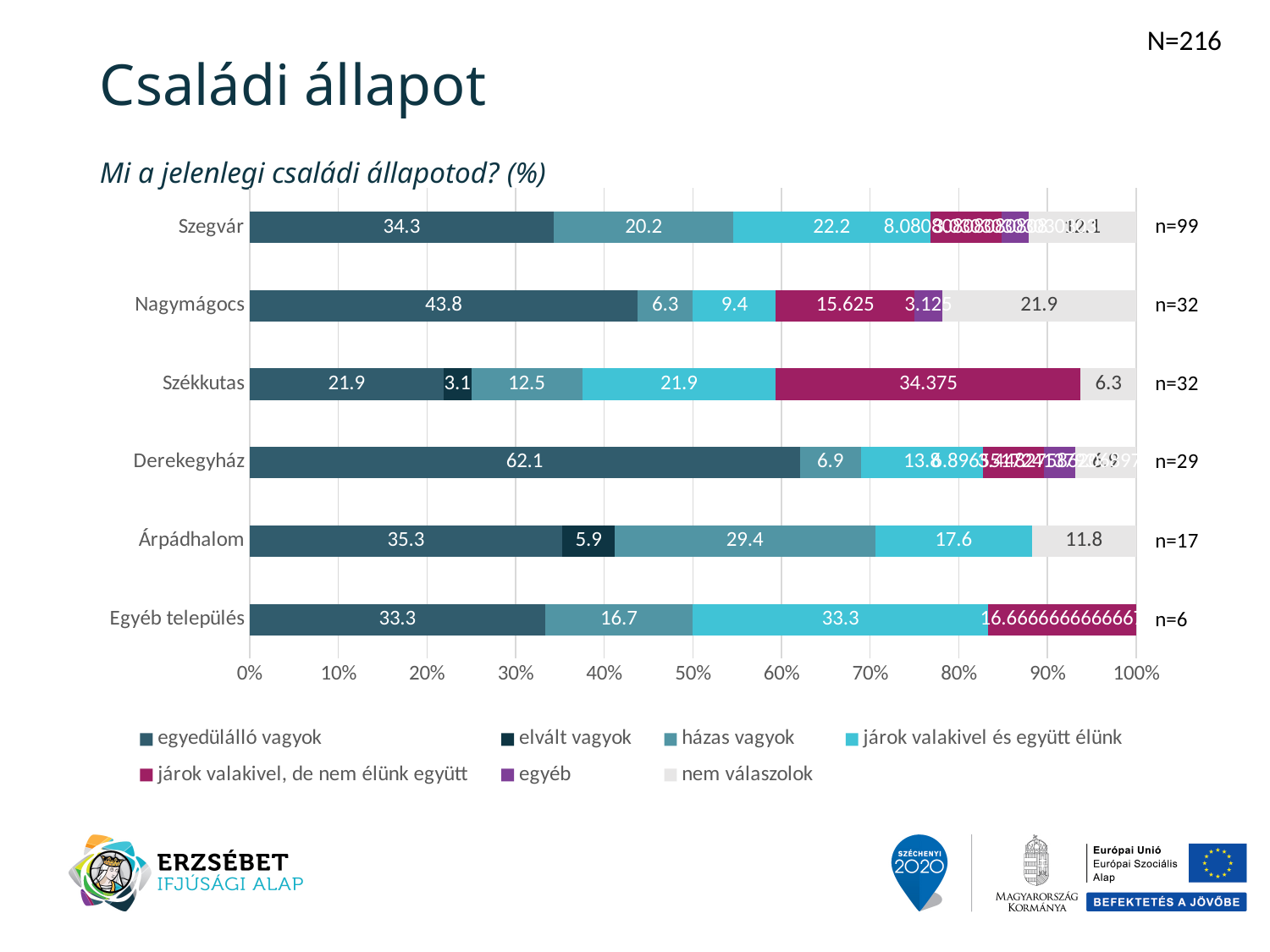
What is the value of 'járok valakivel, de nem élünk együtt' for Székkutas? 34.375 Which settlement has the lowest value for 'egyedülálló vagyok'? Székkutas What kind of chart is shown on the slide? stacked bar chart Which is larger: the 'házas vagyok' value for Szegvár or for Egyéb település? Szegvár Which settlement has the highest value for 'egyedülálló vagyok'? Derekegyház What is the difference between the 'egyedülálló vagyok' values for Nagymágocs and Szegvár? 9.5 What is the value of 'egyedülálló vagyok' for Derekegyház? 62.1 What is the value of 'házas vagyok' for Árpádhalom? 29.4 What is the sample size (n) shown for Szegvár? n=99 How many series does the legend list? 7 What is the value of 'nem válaszolok' for Nagymágocs? 21.9 How many settlements (categories) are shown on the chart? 6